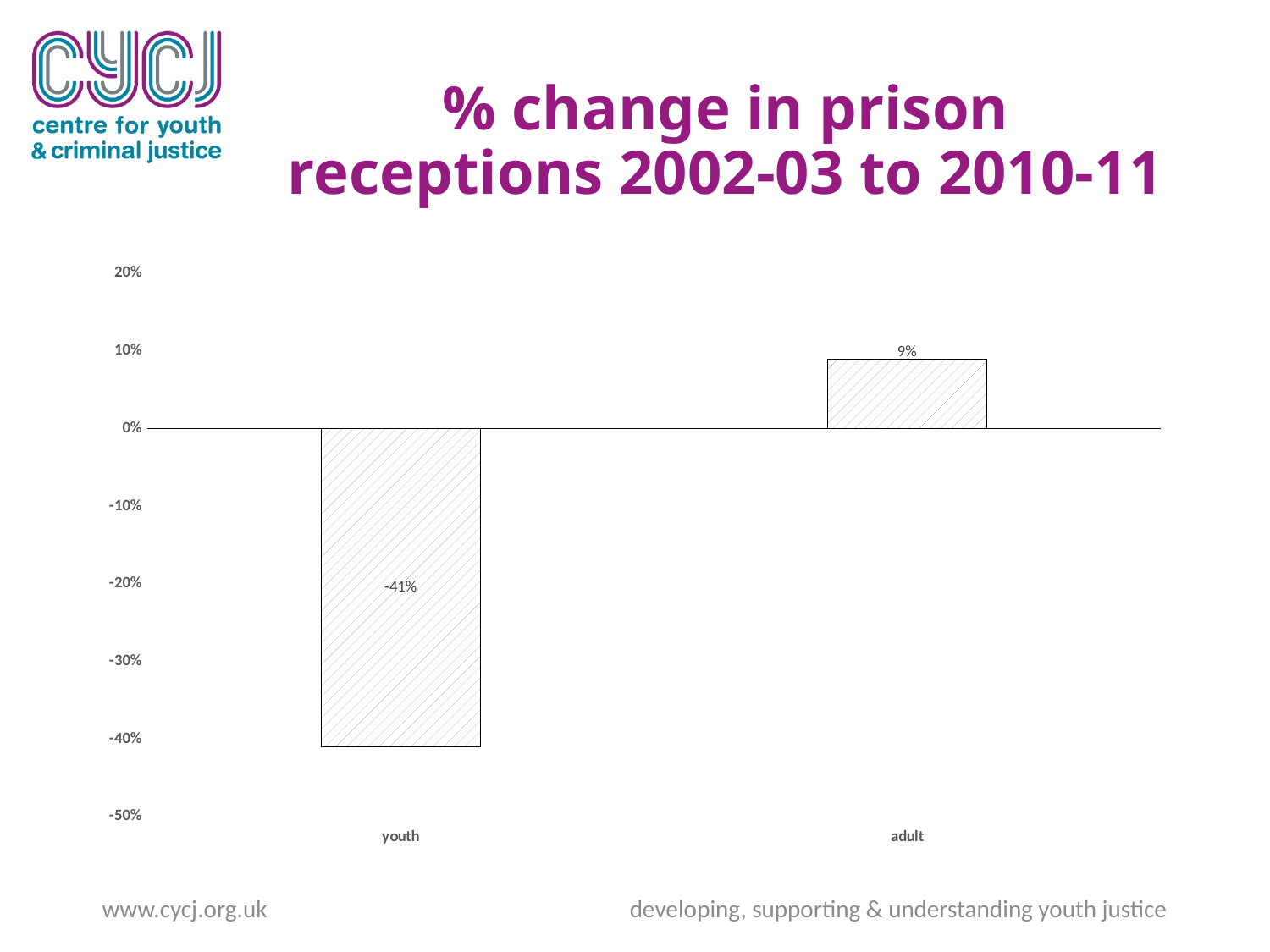
What kind of chart is shown on the slide? bar chart How many categories are shown on the x axis? 2 What is the lowest value shown on the y axis? -50% What is the title of the chart? % change in prison receptions 2002-03 to 2010-11 Is the value for youth greater or less than -40%? less Which category shows the lowest % change in prison receptions? youth What is the difference in percentage points between the adult and youth values? 50 percentage points What is the % change in prison receptions for adult? 9% Which category shows the highest % change in prison receptions? adult Which is larger, the value for youth or the value for adult? adult What is the % change in prison receptions for youth? -41% Is the value for adult greater or less than 10%? less